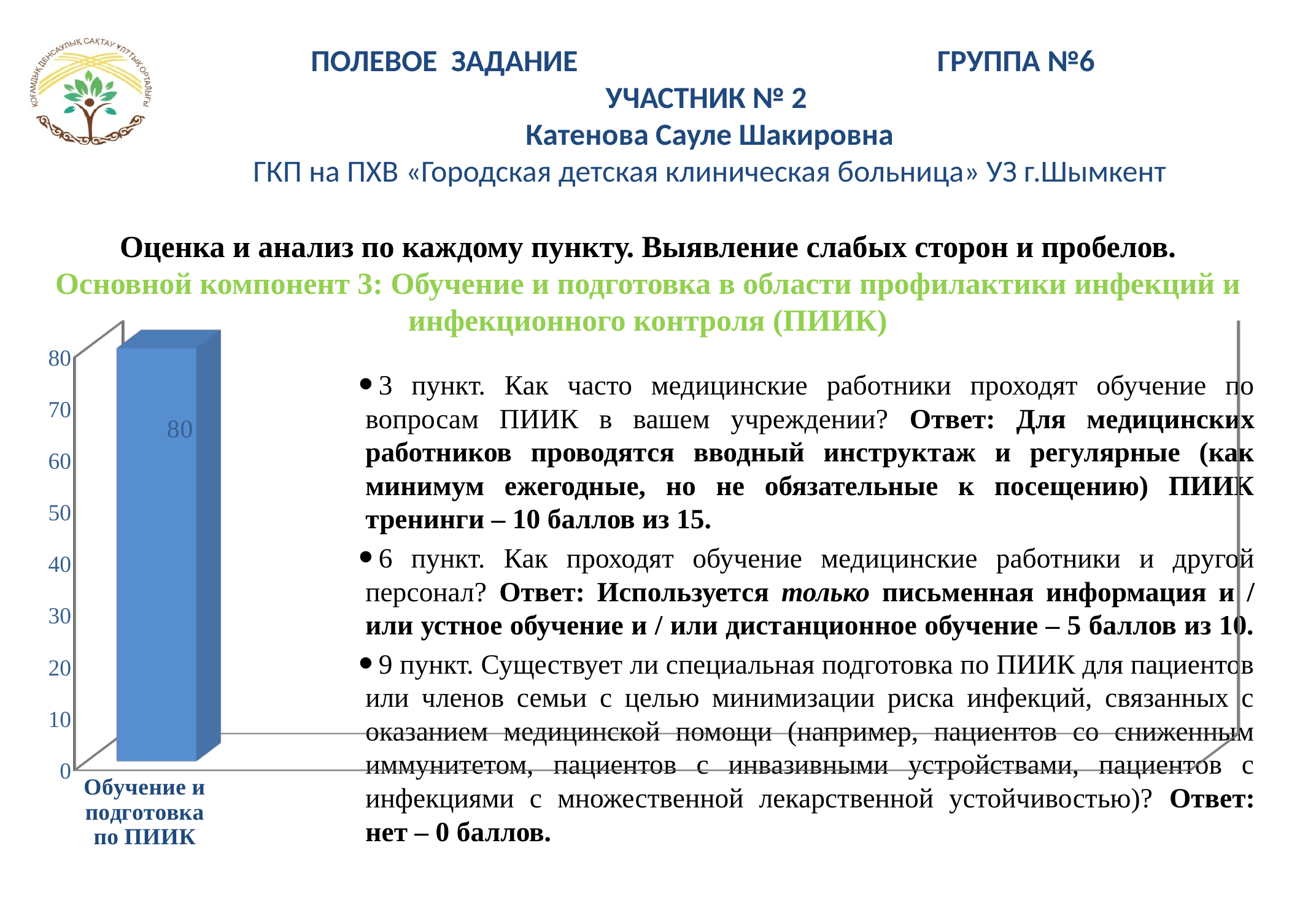
Is the value for "Обучение и подготовка по ПИИК" greater or less than 70? greater How many bars are plotted in the chart? 1 Is the value for "Обучение и подготовка по ПИИК" greater or less than 50? greater What is the lowest value shown on the vertical axis of the chart? 0 What kind of chart is shown on the slide? bar chart What is the highest value shown on the vertical axis of the chart? 80 What is the category label under the bar in the chart? Обучение и подготовка по ПИИК What is the value of the bar for "Обучение и подготовка по ПИИК"? 80